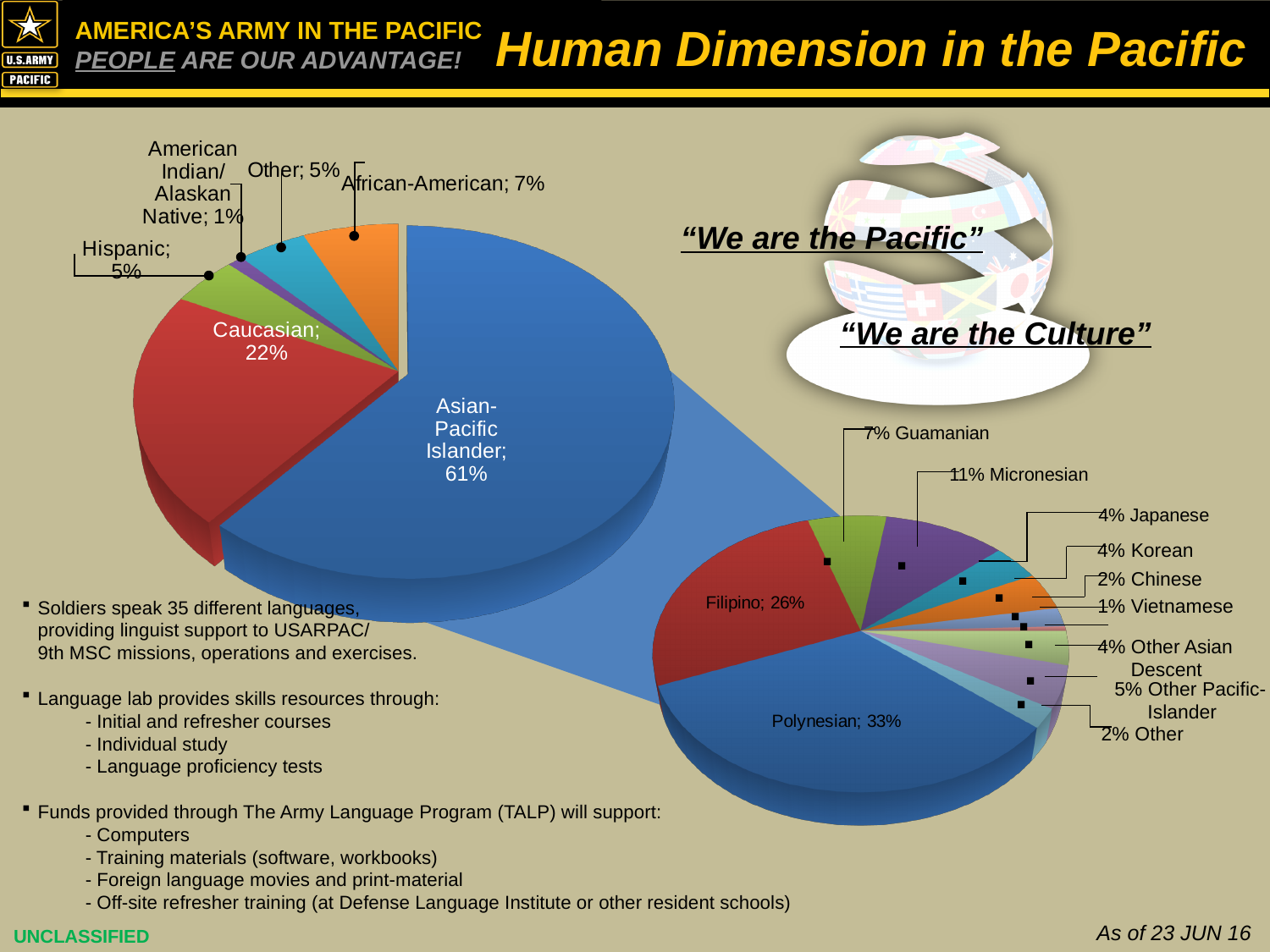
In the lower-right pie chart, which category has the smallest slice? Vietnamese How many slices does the upper-left pie chart have? 6 In the lower-right pie chart, which is larger, Filipino or Guamanian? Filipino What kind of chart is the lower-right chart? Pie chart In the lower-right pie chart, what share is labelled for Polynesian? 33% In the upper-left pie chart, what share is labelled for Caucasian? 22% In the lower-right pie chart, what share is labelled for Micronesian? 11% How many slices does the lower-right pie chart have? 11 In the upper-left pie chart, what share is labelled for Asian-Pacific Islander? 61% In the upper-left pie chart, which category has the smallest slice? American Indian/Alaskan Native In the upper-left pie chart, which category has the largest slice? Asian-Pacific Islander In the upper-left pie chart, what is the difference between the Caucasian share and the African-American share? 15%